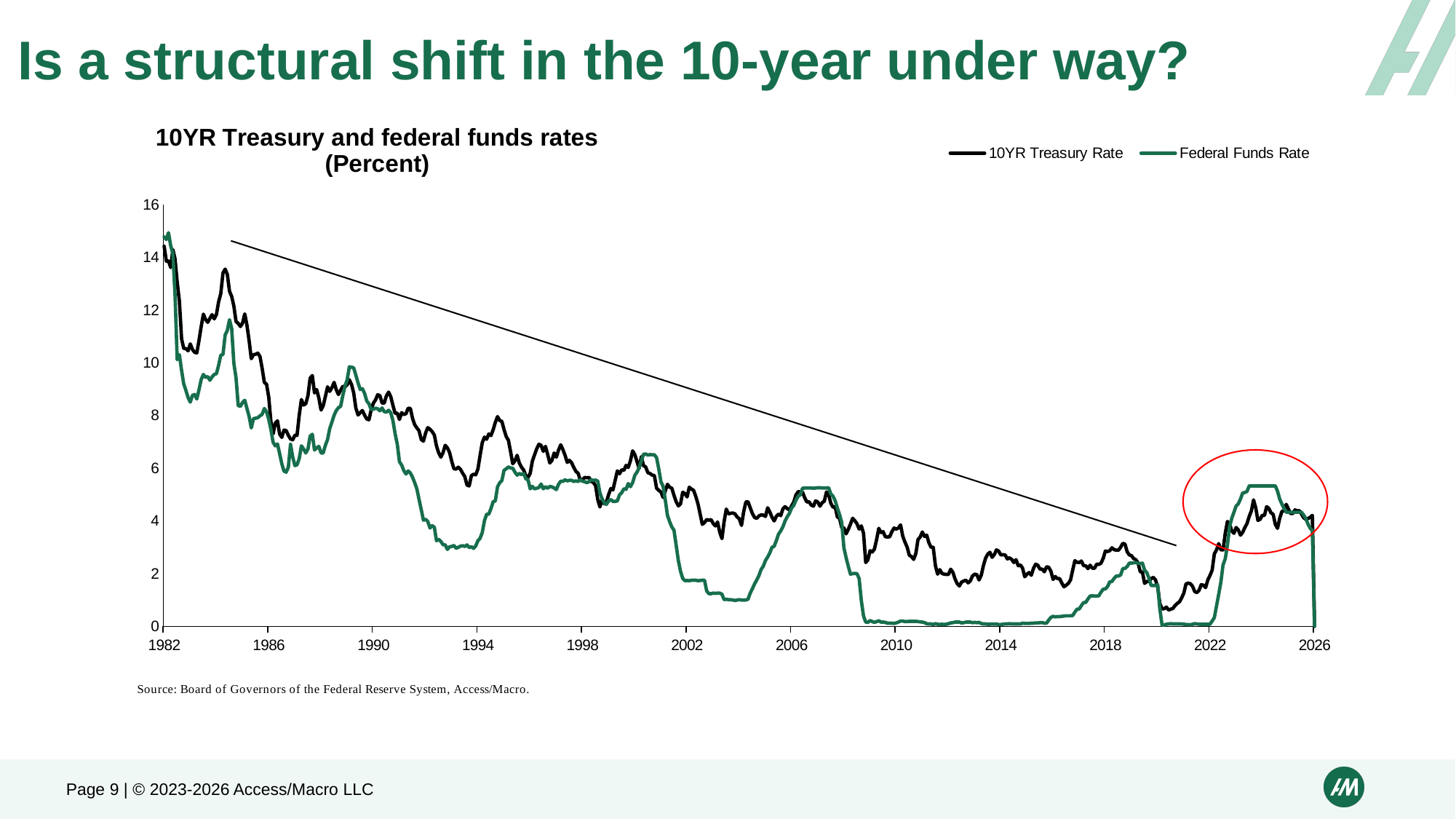
Is the 10YR Treasury Rate at the start of 1982 greater or less than 12? greater How many series does the legend list? 2 Is the Federal Funds Rate in 2012 greater or less than 2? less What is the title of the chart? 10YR Treasury and federal funds rates (Percent) In 2010, which series is higher, the 10YR Treasury Rate or the Federal Funds Rate? 10YR Treasury Rate What kind of chart is shown on the slide? Line chart Is the 10YR Treasury Rate in 1990 greater or less than 6? greater Around which year labelled on the x axis does the 10YR Treasury Rate reach its highest level? 1982 What are the two series named in the legend? 10YR Treasury Rate and Federal Funds Rate Does the 10YR Treasury Rate generally rise or fall from 1982 to 2020? Fall